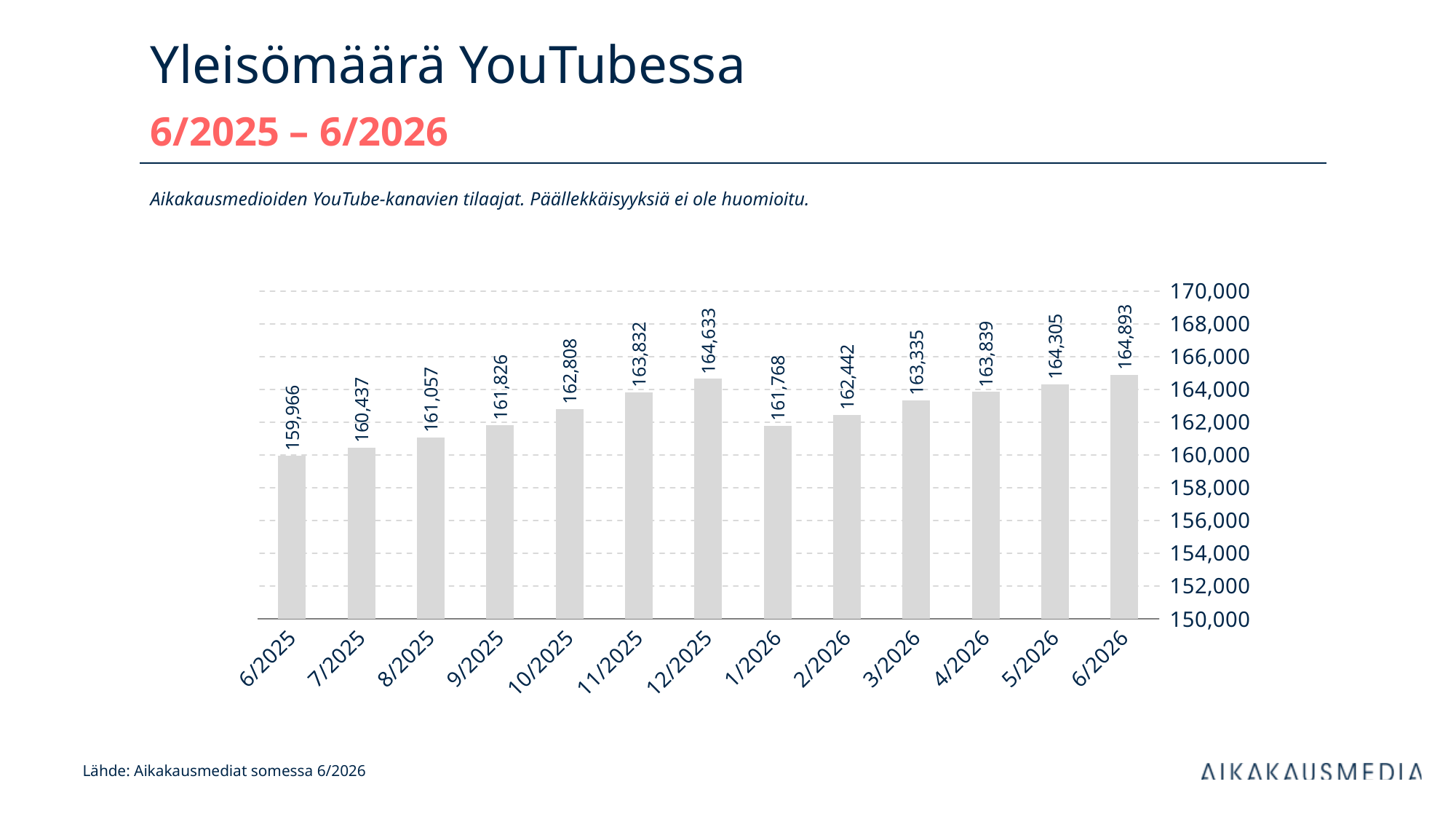
Which month has the highest value? 6/2026 What is the difference between the values for 6/2026 and 6/2025? 4,927 What is the title of the chart on the slide? Yleisömäärä YouTubessa What is the value for 12/2025? 164,633 What is the value for 6/2025? 159,966 What is the difference between the values for 12/2025 and 1/2026? 2,865 What kind of chart is shown on the slide? bar chart Which month has the lowest value? 6/2025 What is the value for 1/2026? 161,768 Is the value for 10/2025 greater or less than 162,000? greater How many months are shown on the x axis? 13 Which is larger, the value for 12/2025 or the value for 5/2026? 12/2025